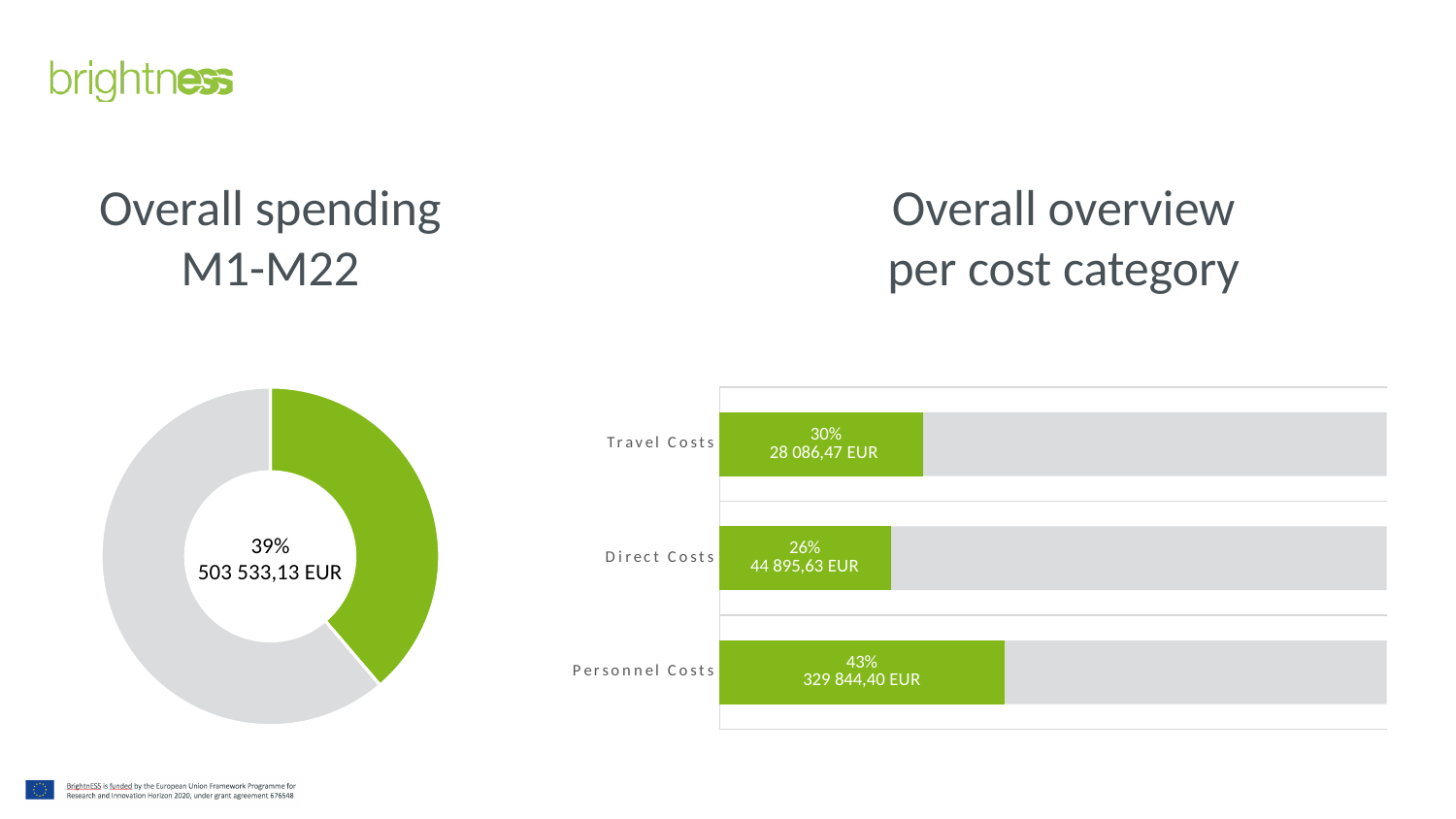
In the 'Overall overview per cost category' chart, what percentage is shown for Personnel Costs? 43% In the 'Overall overview per cost category' chart, which has the higher percentage, Travel Costs or Direct Costs? Travel Costs What kind of chart is the 'Overall overview per cost category' chart? Bar chart In the 'Overall overview per cost category' chart, what is the difference in percentage points between Personnel Costs and Travel Costs? 13% In the 'Overall overview per cost category' chart, what amount in EUR is shown for Direct Costs? 44 895,63 EUR In the 'Overall spending M1-M22' chart, what amount in EUR is shown in the centre of the donut? 503 533,13 EUR In the 'Overall spending M1-M22' chart, what percentage is shown in the centre of the donut? 39% How many cost categories are shown in the 'Overall overview per cost category' chart? 3 In the 'Overall overview per cost category' chart, which cost category has the highest percentage? Personnel Costs In the 'Overall overview per cost category' chart, what amount in EUR is shown for Travel Costs? 28 086,47 EUR In the 'Overall overview per cost category' chart, what percentage is shown for Direct Costs? 26% In the 'Overall overview per cost category' chart, which cost category has the lowest percentage? Direct Costs